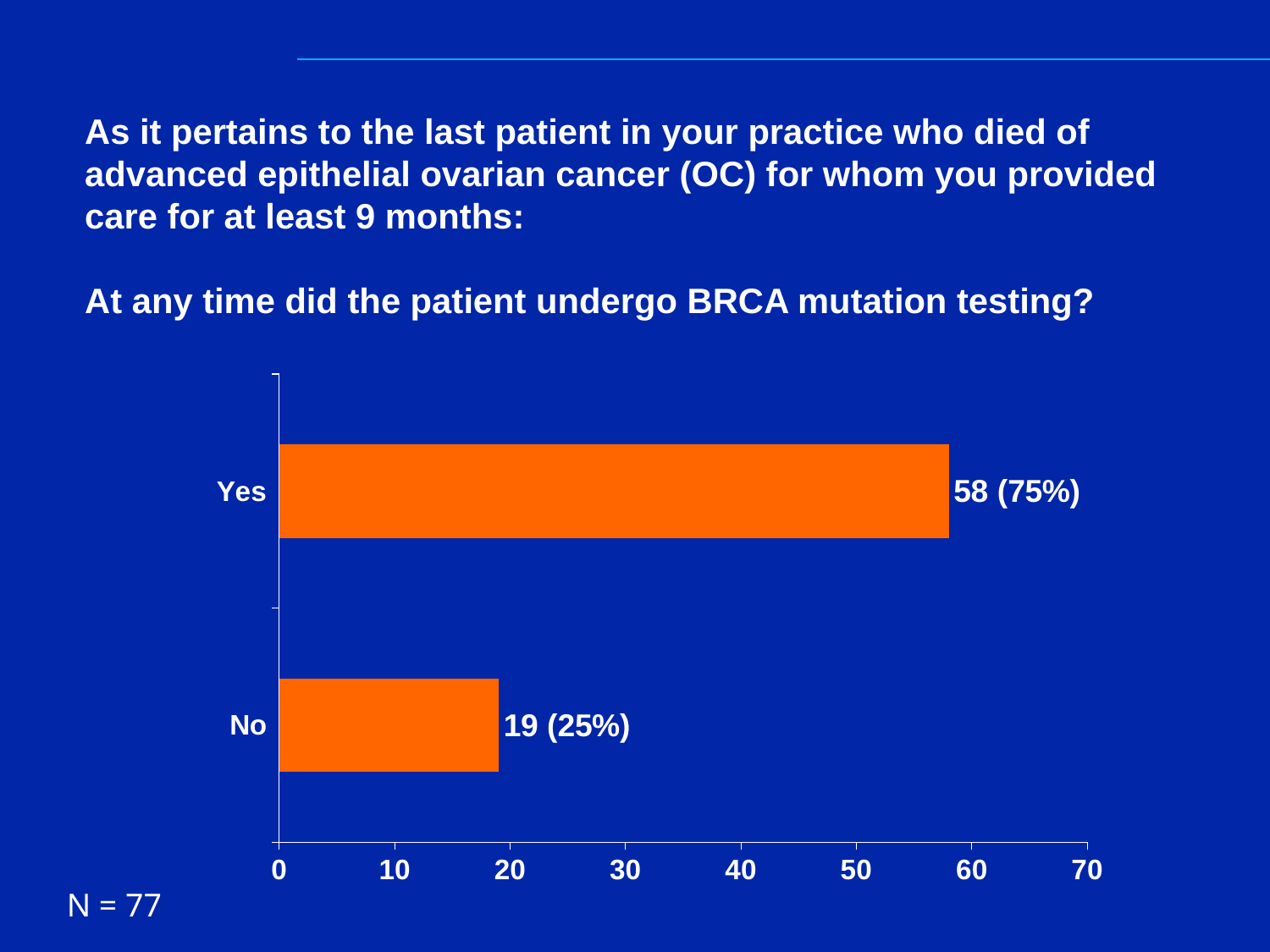
Which response has a larger count, "Yes" or "No"? Yes What percentage of respondents answered "No"? 25% Which response category has the lowest count? No How many respondents answered "No" to whether the patient underwent BRCA mutation testing? 19 (25%) What percentage of respondents answered "Yes"? 75% What type of chart is shown on the slide? Bar chart Is the count for "Yes" greater or less than 50? greater What is the total number of respondents (N) stated on the slide? 77 What is the difference in count between the "Yes" and "No" responses? 39 Which response category has the highest count? Yes How many respondents answered "Yes" to whether the patient underwent BRCA mutation testing? 58 (75%) How many response categories are shown in the chart? 2